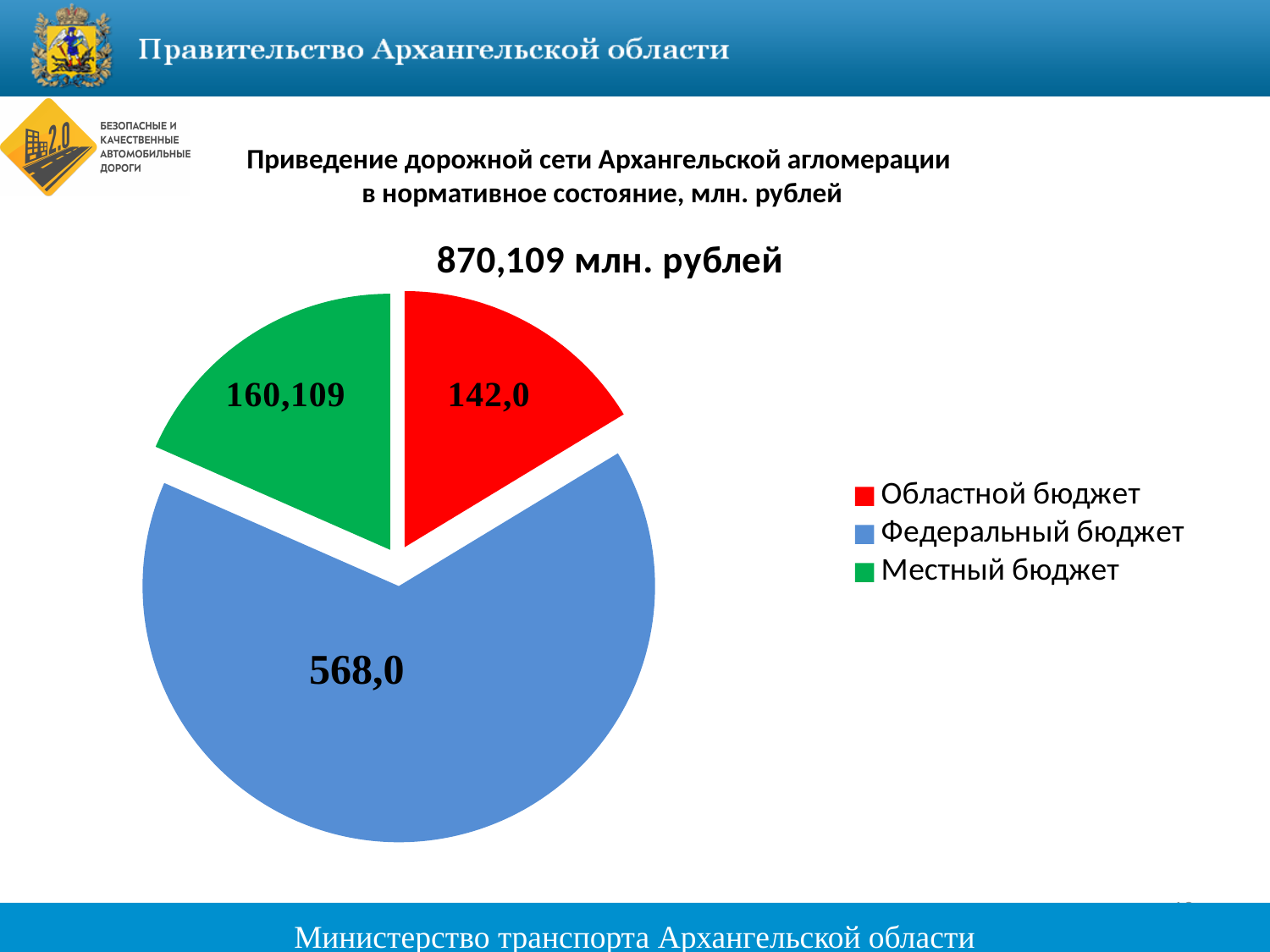
What is the value for Местный бюджет? 160,109 Which budget source has the largest slice of the pie? Федеральный бюджет What is the difference between the values for Федеральный бюджет and Областной бюджет? 426,0 How many entries does the legend list? 3 What is the difference between the values for Местный бюджет and Областной бюджет? 18,109 What is the value for Федеральный бюджет? 568,0 Which budget source has the smallest slice of the pie? Областной бюджет What is the value for Областной бюджет? 142,0 How many slices does the pie chart have? 3 Which is larger, Местный бюджет or Областной бюджет? Местный бюджет What total amount is shown as the chart title? 870,109 млн. рублей What kind of chart is shown on the slide? Pie chart